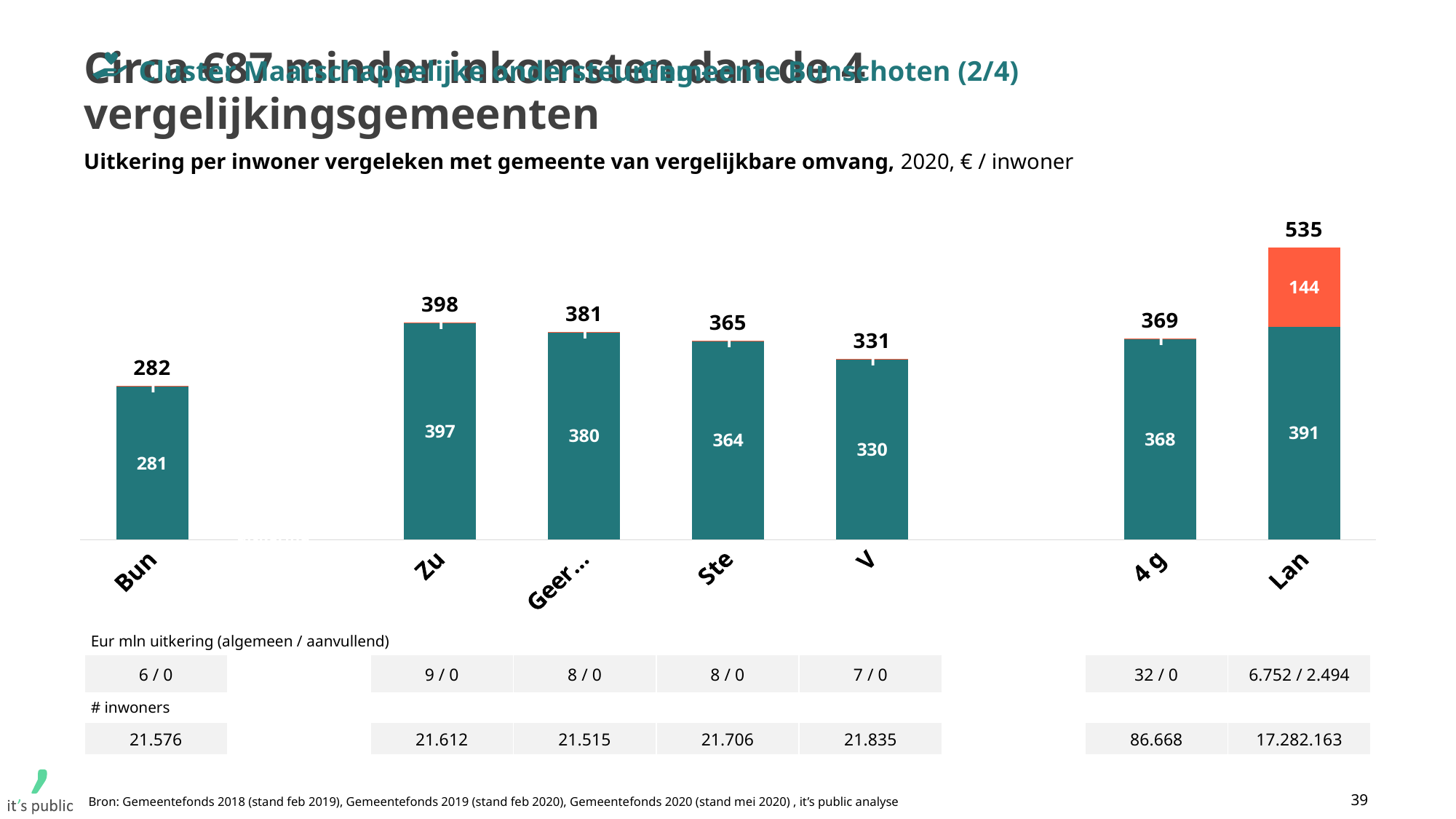
Which has a larger total value, Zu or Geer…? Zu What value is printed in the orange segment of the Lan bar? 144 What value is printed inside the teal segment of the Zu bar? 397 What is the total of the stacked bar for Lan (teal 391 plus orange 144)? 535 Which category has the lowest total value? Bun How many bars are shown in the chart? 7 What is the total value shown above the bar for Bun? 282 Which category has the highest total value? Lan What kind of chart is shown on the slide? Bar chart What is the difference between the total for Lan and the total for Bun? 253 What is the difference between the total for Zu and the total for Ste? 33 What is the total value shown above the bar for V? 331